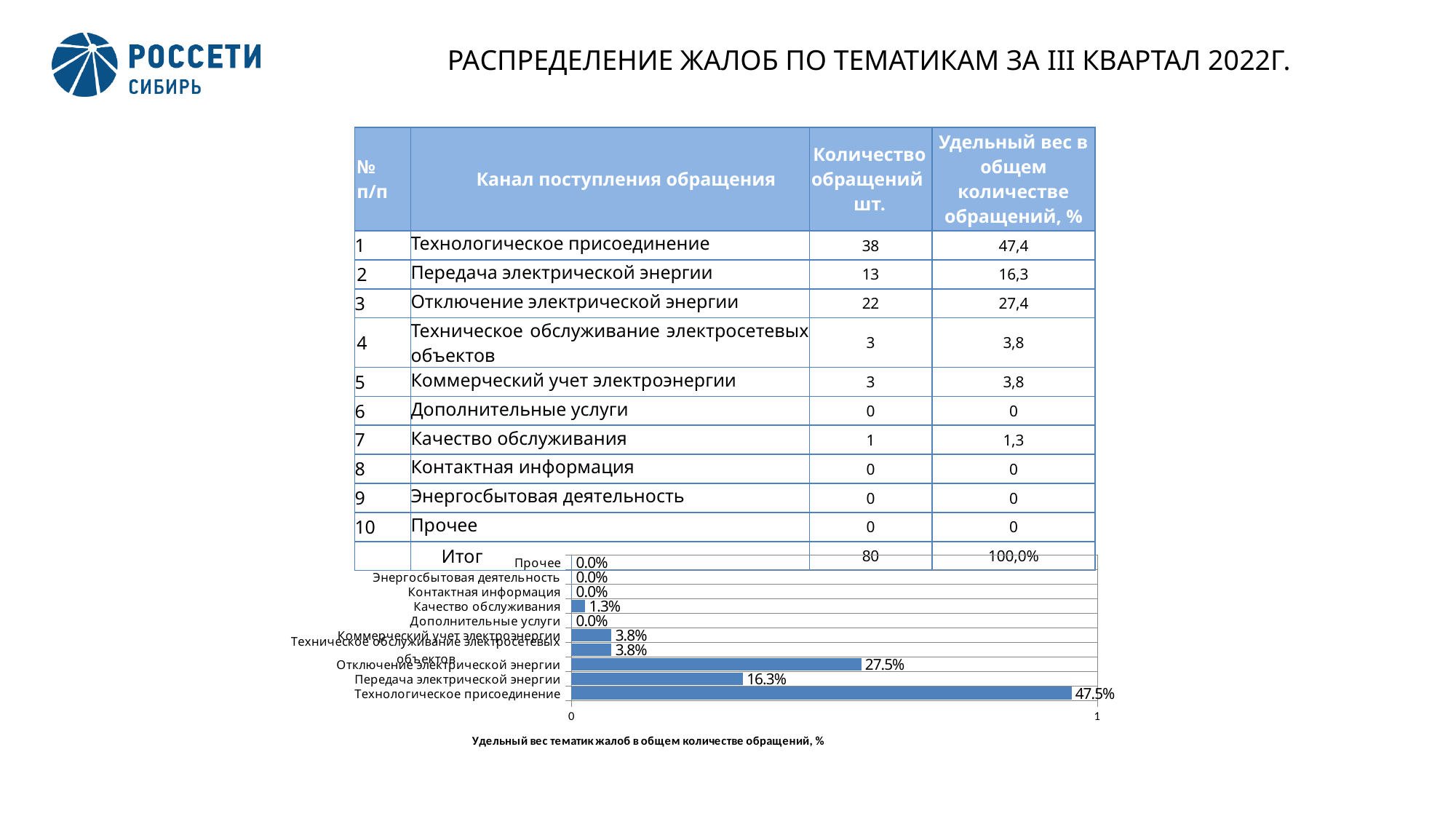
In the chart, what is the value for Отключение электрической энергии? 27.5% What kind of chart is shown on the slide? bar chart In the chart, what is the value for Передача электрической энергии? 16.3% In the chart, what is the value for Коммерческий учет электроэнергии? 3.8% Which category has the highest value in the chart? Технологическое присоединение How many categories are plotted in the chart? 10 In the chart, which is larger: Отключение электрической энергии or Передача электрической энергии? Отключение электрической энергии In the chart, what is the difference between the values for Отключение электрической энергии and Передача электрической энергии? 11.2% In the chart, what is the value for Технологическое присоединение? 47.5% What is the title of the chart on the slide? Удельный вес тематик жалоб в общем количестве обращений, % In the chart, what is the value for Качество обслуживания? 1.3% In the chart, what is the difference between the values for Технологическое присоединение and Отключение электрической энергии? 20.0%